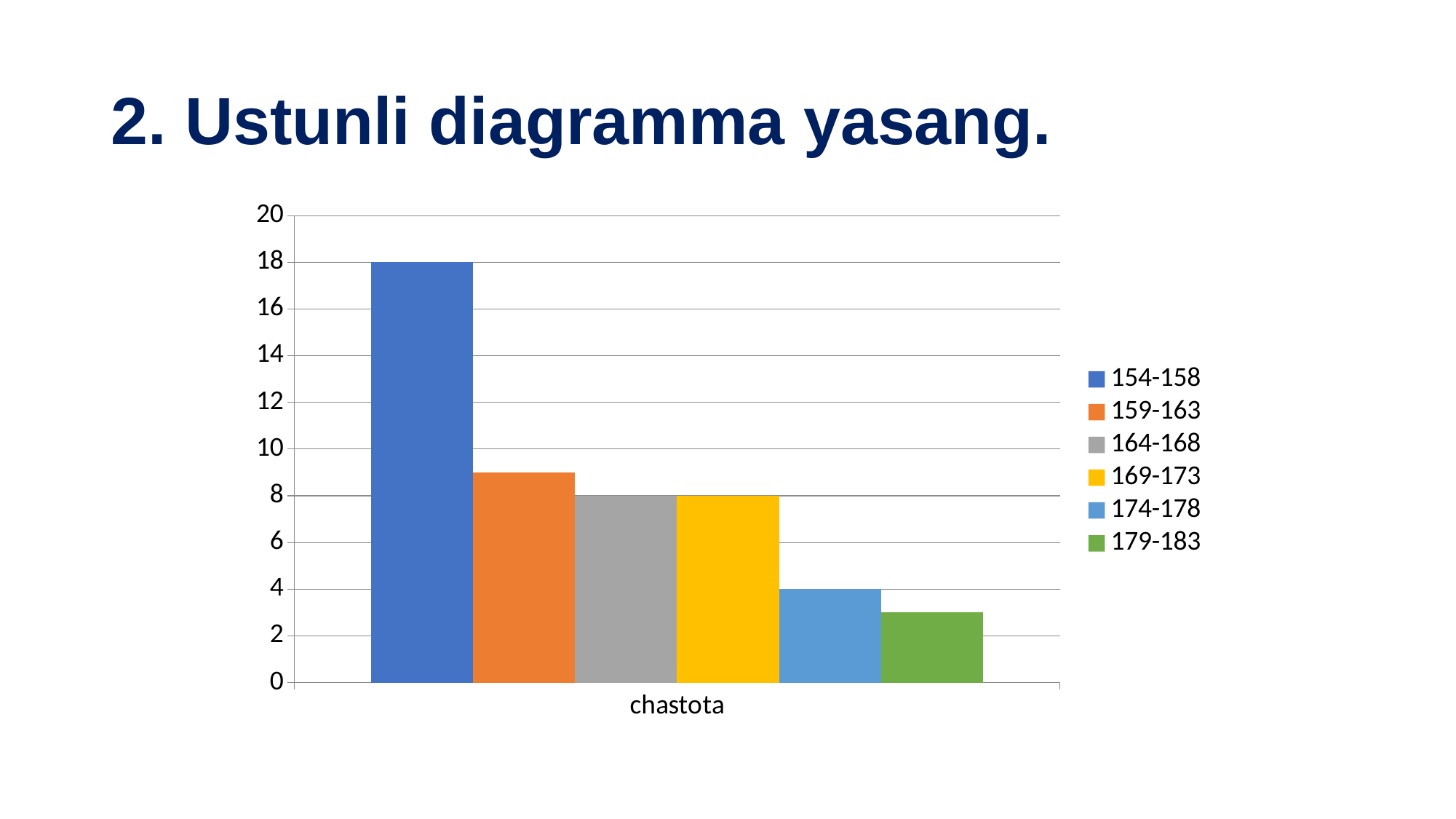
Which series has the highest bar in the chart? 154-158 What is the difference between the values for 154-158 and 164-168? 10 What is the value of the 164-168 series in the chart? 8 What kind of chart is shown on the slide? bar chart Is the value for 179-183 greater or less than 2? greater What is the value of the 174-178 series in the chart? 4 Which is larger, the value for 154-158 or the value for 159-163? 154-158 Is the value for 159-163 greater or less than 10? less What is the difference between the values for 169-173 and 174-178? 4 Which series has the lowest bar in the chart? 179-183 What is the value of the 154-158 series in the chart? 18 How many series does the legend list? 6